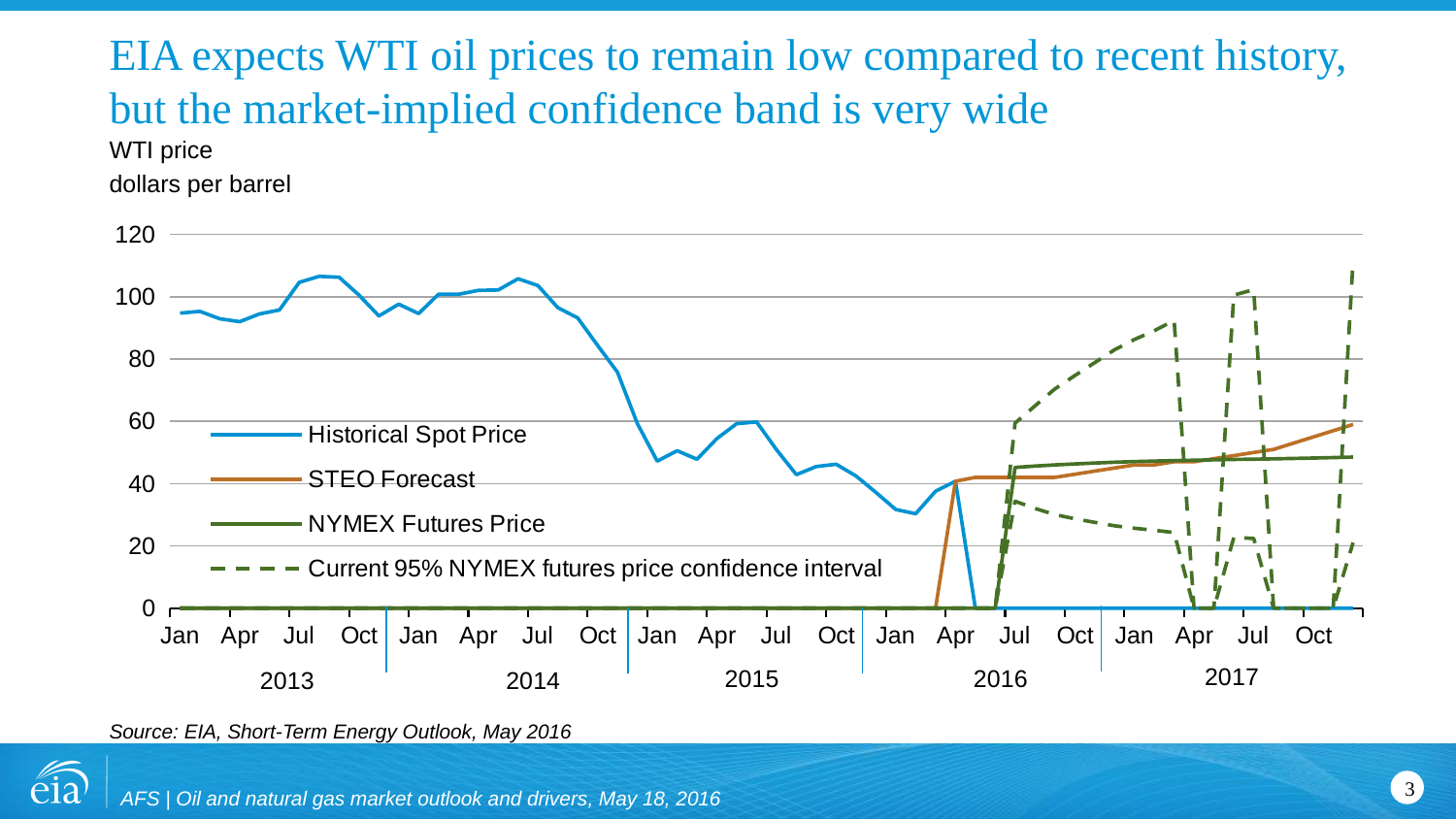
Which is larger, the Historical Spot Price in Jul 2013 or in Jul 2015? Jul 2013 Is the lower line of the 95% NYMEX futures price confidence interval in Jan 2017 greater or less than 40? less Is the Historical Spot Price in Jan 2016 greater or less than 40? less Does the Historical Spot Price rise or fall between Jul 2014 and Jan 2015? fall How many series does the legend list? 4 What source is cited for the chart? EIA, Short-Term Energy Outlook, May 2016 Does the STEO Forecast rise or fall from Jul 2016 to the end of 2017? rise Is the Historical Spot Price in Jan 2013 greater or less than 80? greater What unit is the WTI price measured in on the chart? dollars per barrel What kind of chart is shown on the slide? line chart